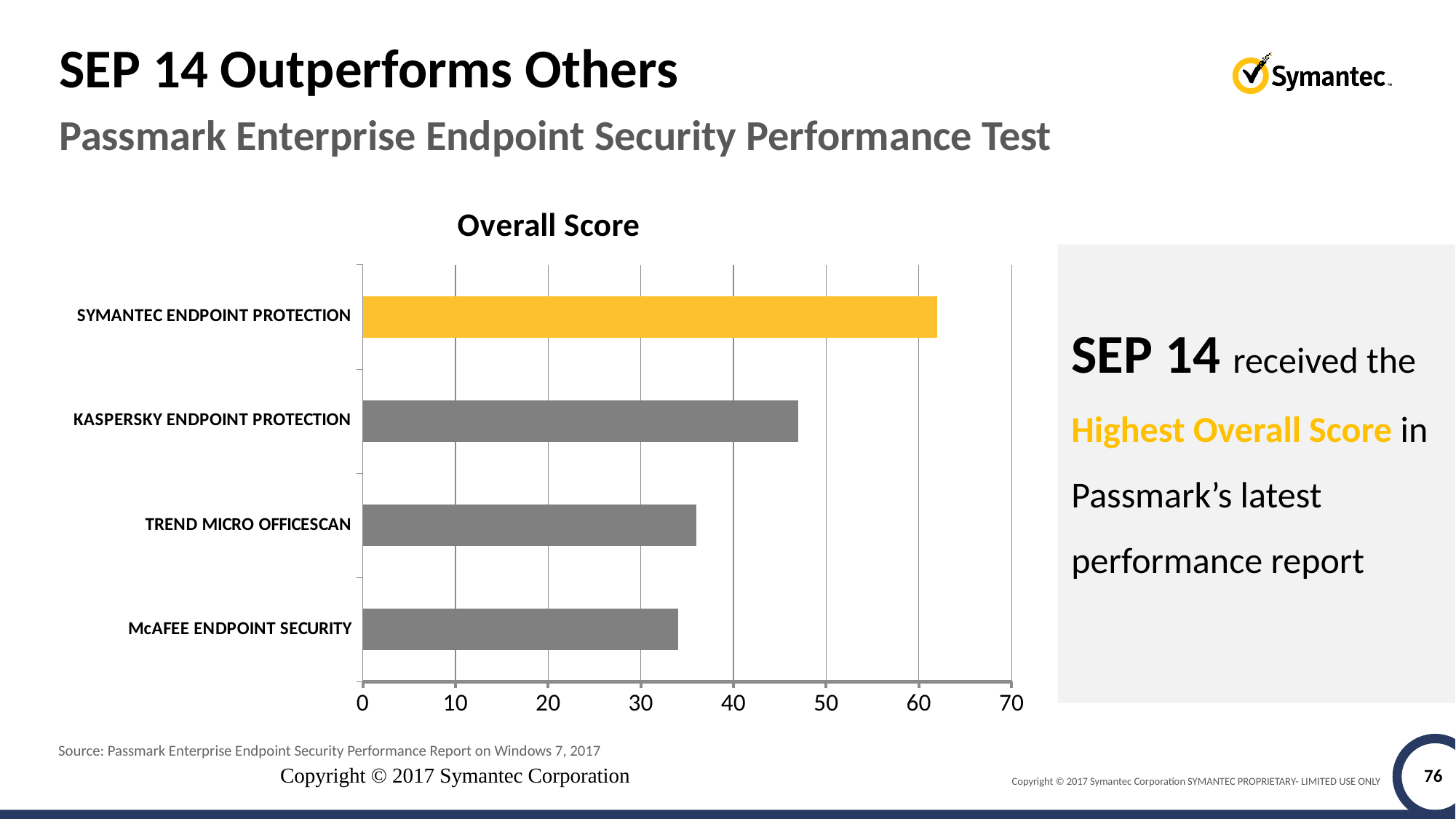
What kind of chart is shown on the slide? bar chart What is the title of the chart? Overall Score Is the Overall Score for KASPERSKY ENDPOINT PROTECTION greater or less than 40? greater How many products are plotted in the Overall Score chart? 4 Which has a higher Overall Score, KASPERSKY ENDPOINT PROTECTION or TREND MICRO OFFICESCAN? KASPERSKY ENDPOINT PROTECTION Is the Overall Score for TREND MICRO OFFICESCAN greater or less than 40? less Is the Overall Score for SYMANTEC ENDPOINT PROTECTION greater or less than 60? greater Which bar in the chart is coloured yellow rather than grey? SYMANTEC ENDPOINT PROTECTION Which has a higher Overall Score, SYMANTEC ENDPOINT PROTECTION or KASPERSKY ENDPOINT PROTECTION? SYMANTEC ENDPOINT PROTECTION Which product has the highest Overall Score? SYMANTEC ENDPOINT PROTECTION